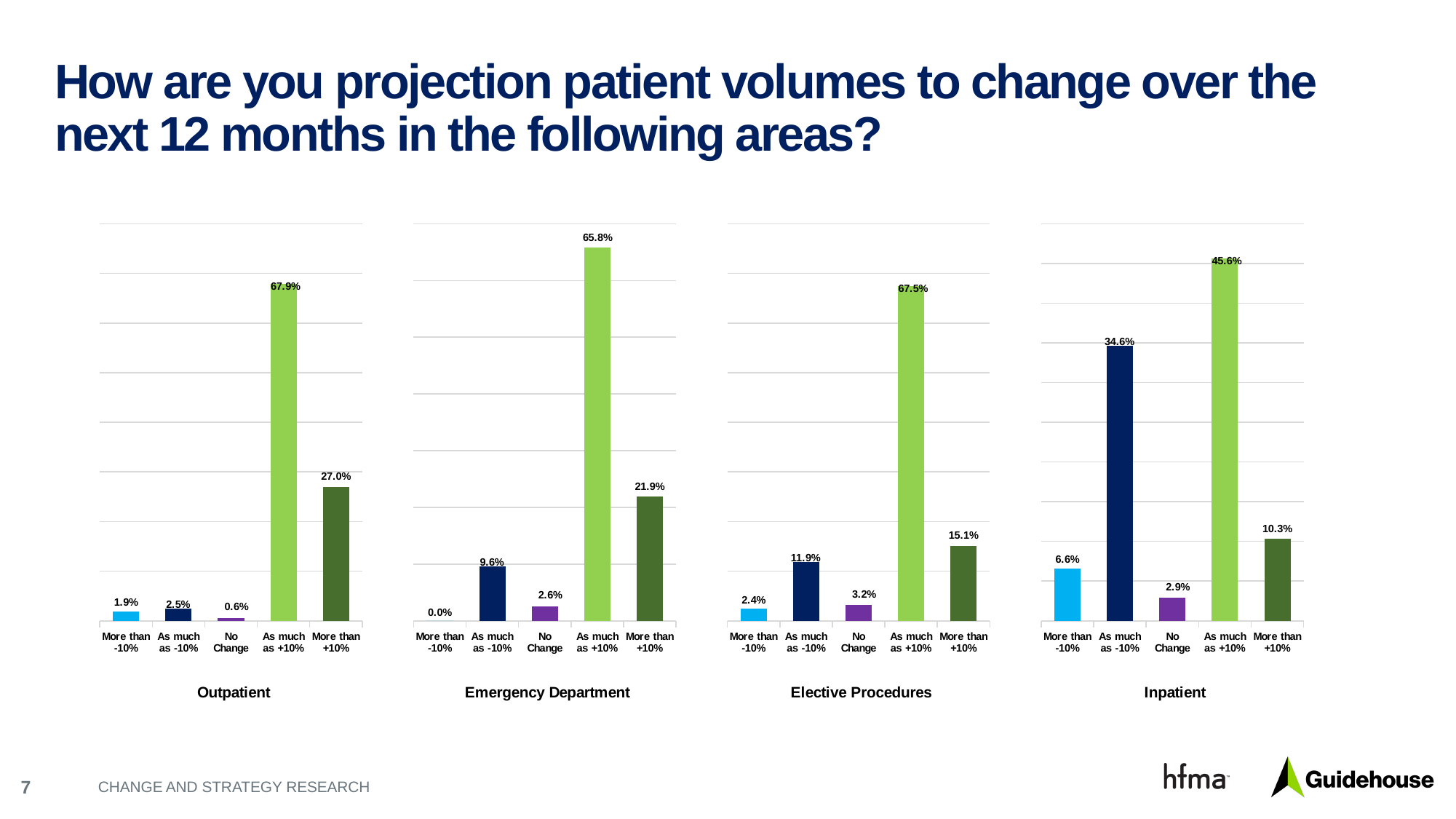
How many categories does the Emergency Department chart show? 5 In the Elective Procedures chart, what is the difference between "As much as +10%" and "More than +10%"? 52.4% What kind of chart is the Elective Procedures chart? Bar chart Which is larger: "More than +10%" in the Outpatient chart or "More than +10%" in the Inpatient chart? Outpatient In the Emergency Department chart, which category has the lowest value? More than -10% In the Elective Procedures chart, what is the value for "No Change"? 3.2% In the Inpatient chart, what is the value for "As much as -10%"? 34.6% In the Outpatient chart, what is the value for "As much as +10%"? 67.9% In the Emergency Department chart, what is the value for "More than +10%"? 21.9% In the Inpatient chart, what is the difference between "As much as +10%" and "As much as -10%"? 11.0% In the Outpatient chart, which category has the lowest value? No Change In the Inpatient chart, which category has the highest value? As much as +10%